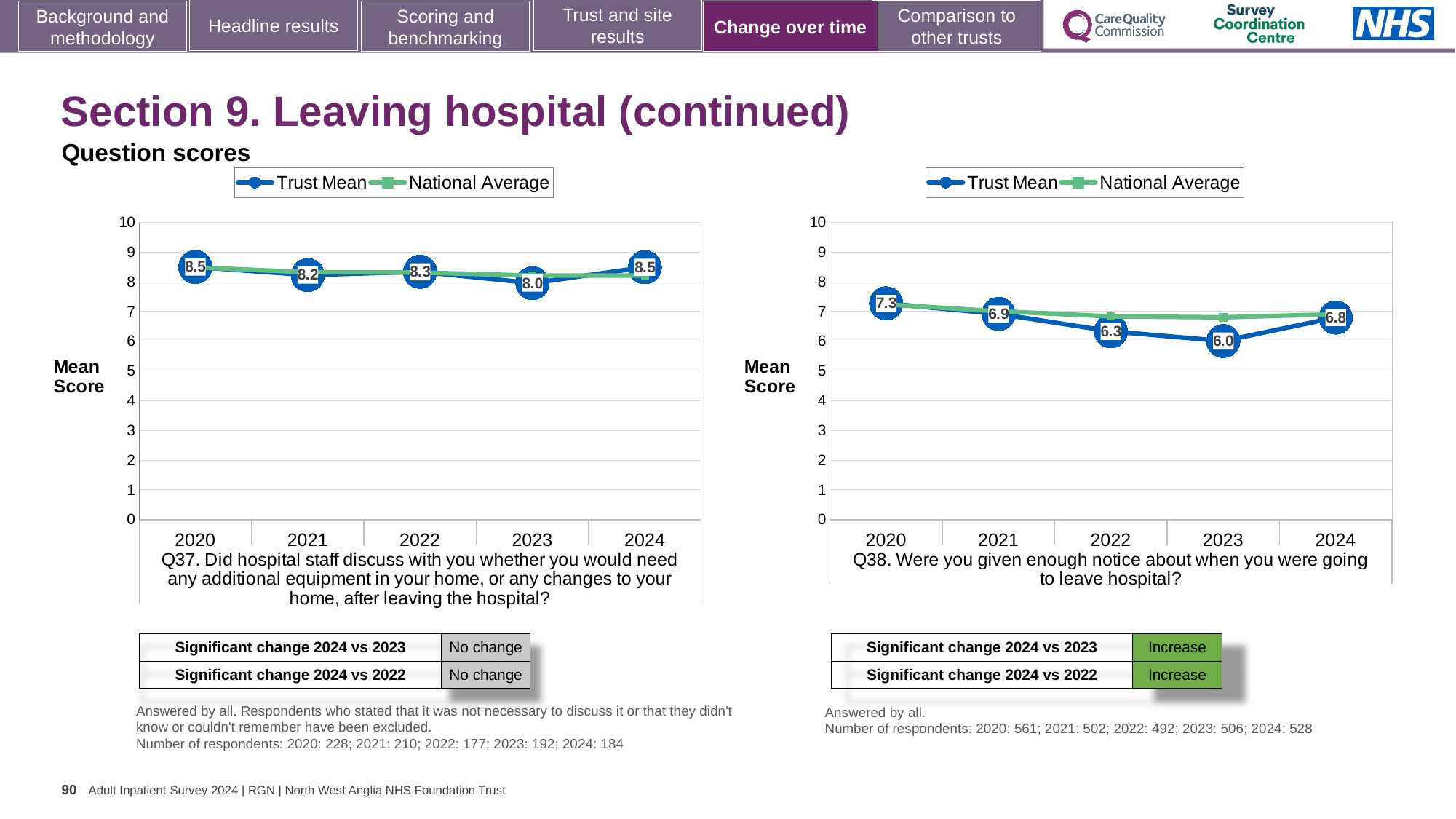
How many series does the legend of the Q38 chart on the right list? 2 How many years are plotted on the x axis of the Q37 chart on the left? 5 In the Q38 chart on the right, what is the Trust Mean score for 2023? 6.0 What type of chart is used for Q37 on the left? Line chart In the Q37 chart on the left, which year has the lowest Trust Mean score? 2023 In the Q37 chart on the left, what is the difference between the Trust Mean scores for 2024 and 2023? 0.5 In the Q38 chart on the right, is the Trust Mean score for 2022 higher or lower than the score for 2024? lower In the Q38 chart on the right, does the Trust Mean score rise or fall from 2020 to 2023? fall In the Q38 chart on the right, is the National Average value for 2020 greater or less than 5? greater In the Q38 chart on the right, what is the difference between the Trust Mean scores for 2020 and 2023? 1.3 In the Q38 chart on the right, which year has the highest Trust Mean score? 2020 In the Q37 chart on the left, what is the Trust Mean score for 2024? 8.5